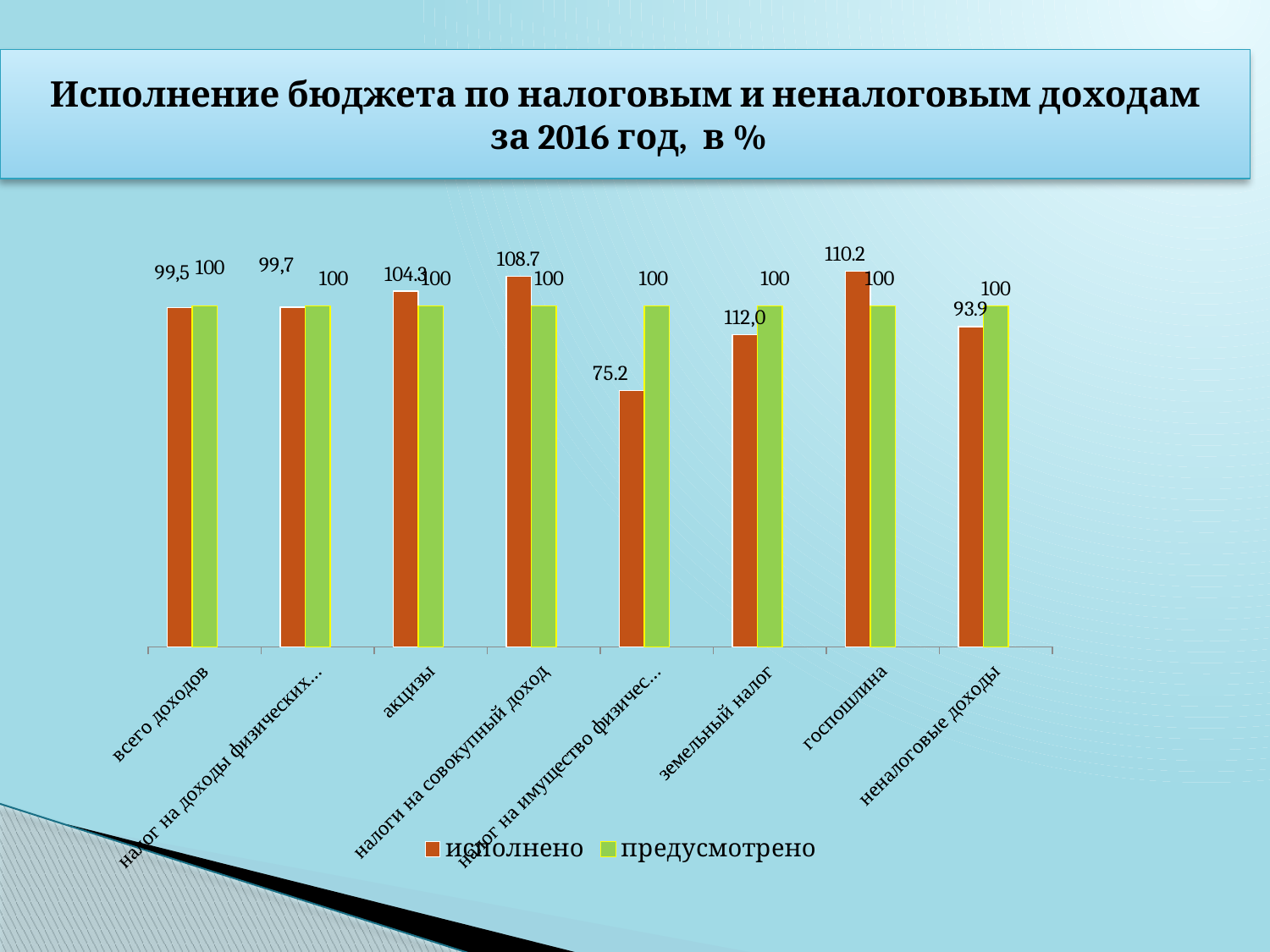
What is the difference between исполнено and предусмотрено for налоги на совокупный доход? 8.7 How many categories are shown on the x axis? 8 How many series does the legend list? 2 For акцизы, which is larger: исполнено or предусмотрено? исполнено What is the value of исполнено for неналоговые доходы? 93.9 What is the difference between предусмотрено and исполнено for налог на имущество физичес...? 24.8 Which category has the lowest исполнено value? налог на имущество физичес... What kind of chart is shown on the slide? bar chart What is the value of исполнено for госпошлина? 110.2 What is the value of предусмотрено for всего доходов? 100 What is the value of исполнено for акцизы? 104.3 What is the value of исполнено for налоги на совокупный доход? 108.7